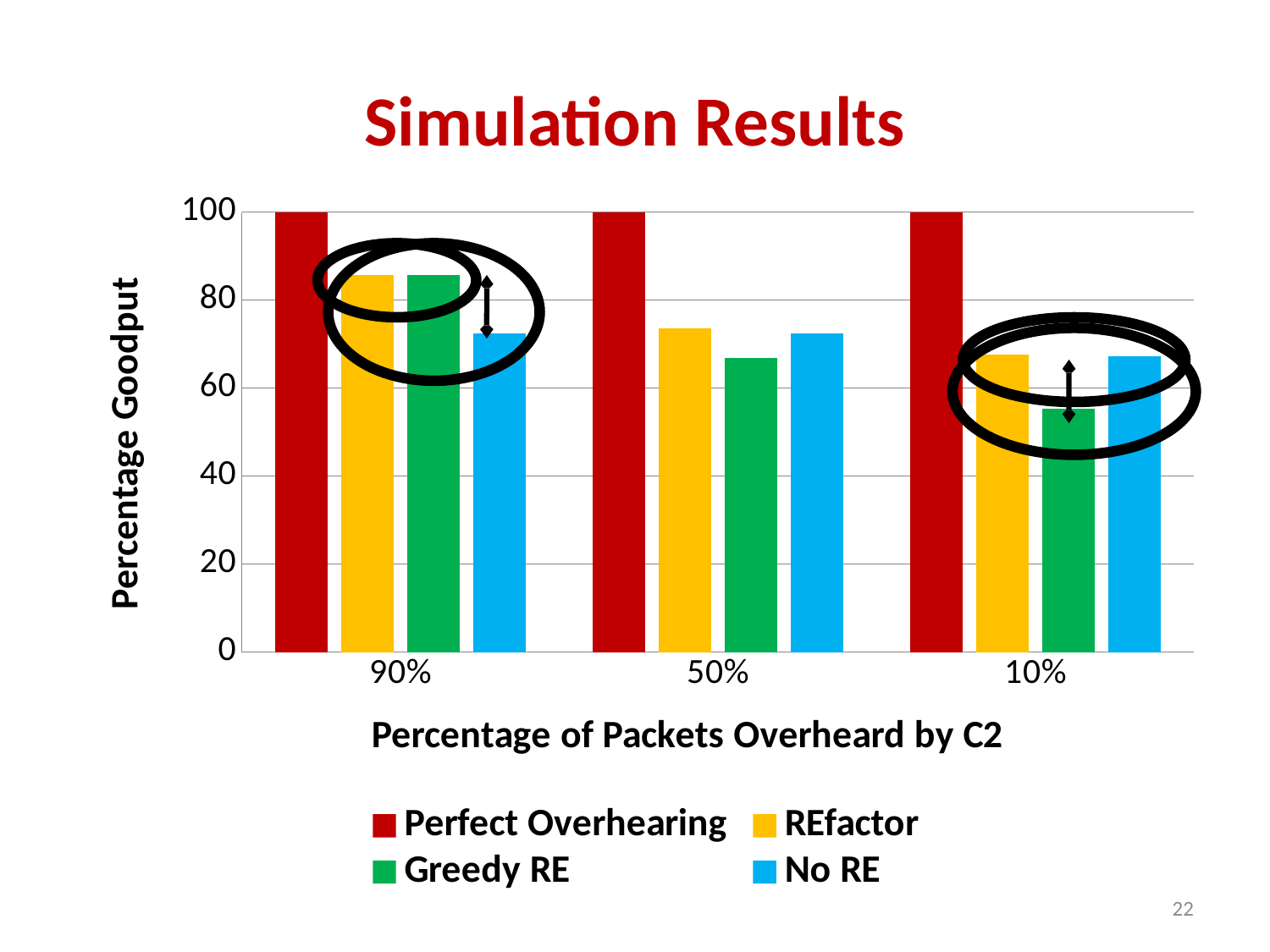
In the 90% category, which is larger: Greedy RE or No RE? Greedy RE What is the Percentage Goodput for Perfect Overhearing at 10% packets overheard? 100 Which series has the lowest value in the 10% category? Greedy RE Is the value for Greedy RE at 50% greater or less than 80? less What is the Percentage Goodput for Perfect Overhearing at 90% packets overheard? 100 Is the value for Greedy RE at 10% greater or less than 60? less How many categories are shown on the x axis? 3 How many series does the legend list? 4 Is the value for REfactor at 90% greater or less than 80? greater What is the label of the y axis? Percentage Goodput Do the Greedy RE values rise or fall moving from 90% to 10% along the x axis? fall What kind of chart is shown on the slide? bar chart